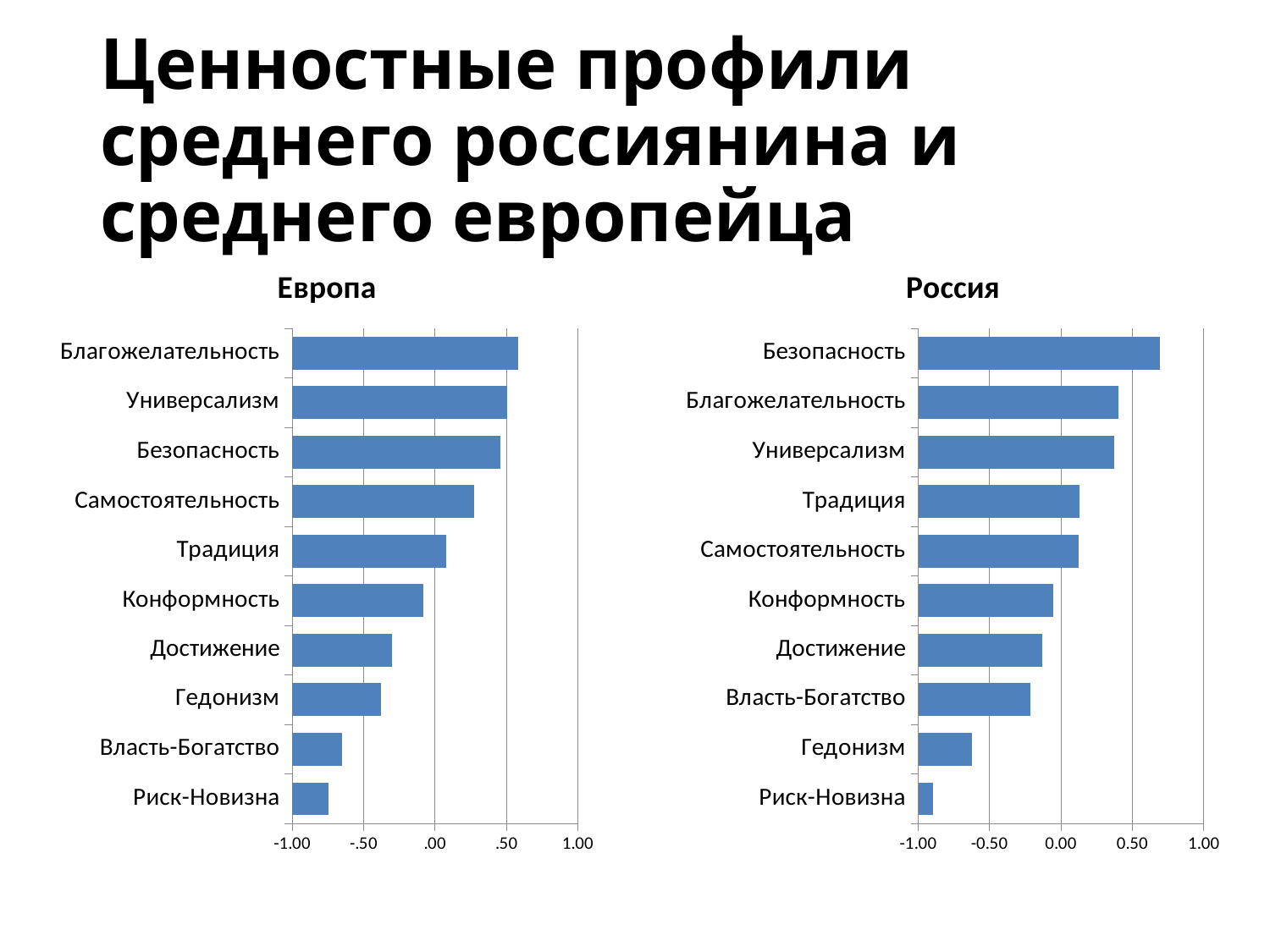
In the "Европа" chart, which category has the lowest value? Риск-Новизна In the "Россия" chart, is the value for Гедонизм greater or less than -0.50? less What kind of chart is the "Европа" chart? bar chart How many categories are shown in the "Россия" chart? 10 In the "Россия" chart, which is larger: the value for Власть-Богатство or the value for Гедонизм? Власть-Богатство In the "Европа" chart, is the value for Власть-Богатство greater or less than -.50? less In the "Европа" chart, which category has the highest value? Благожелательность What are the titles of the two charts on the slide? Европа and Россия In the "Россия" chart, is the value for Безопасность greater or less than 0.50? greater In the "Россия" chart, which category has the highest value? Безопасность In the "Россия" chart, which category has the lowest value? Риск-Новизна In the "Европа" chart, which is larger: the value for Самостоятельность or the value for Традиция? Самостоятельность